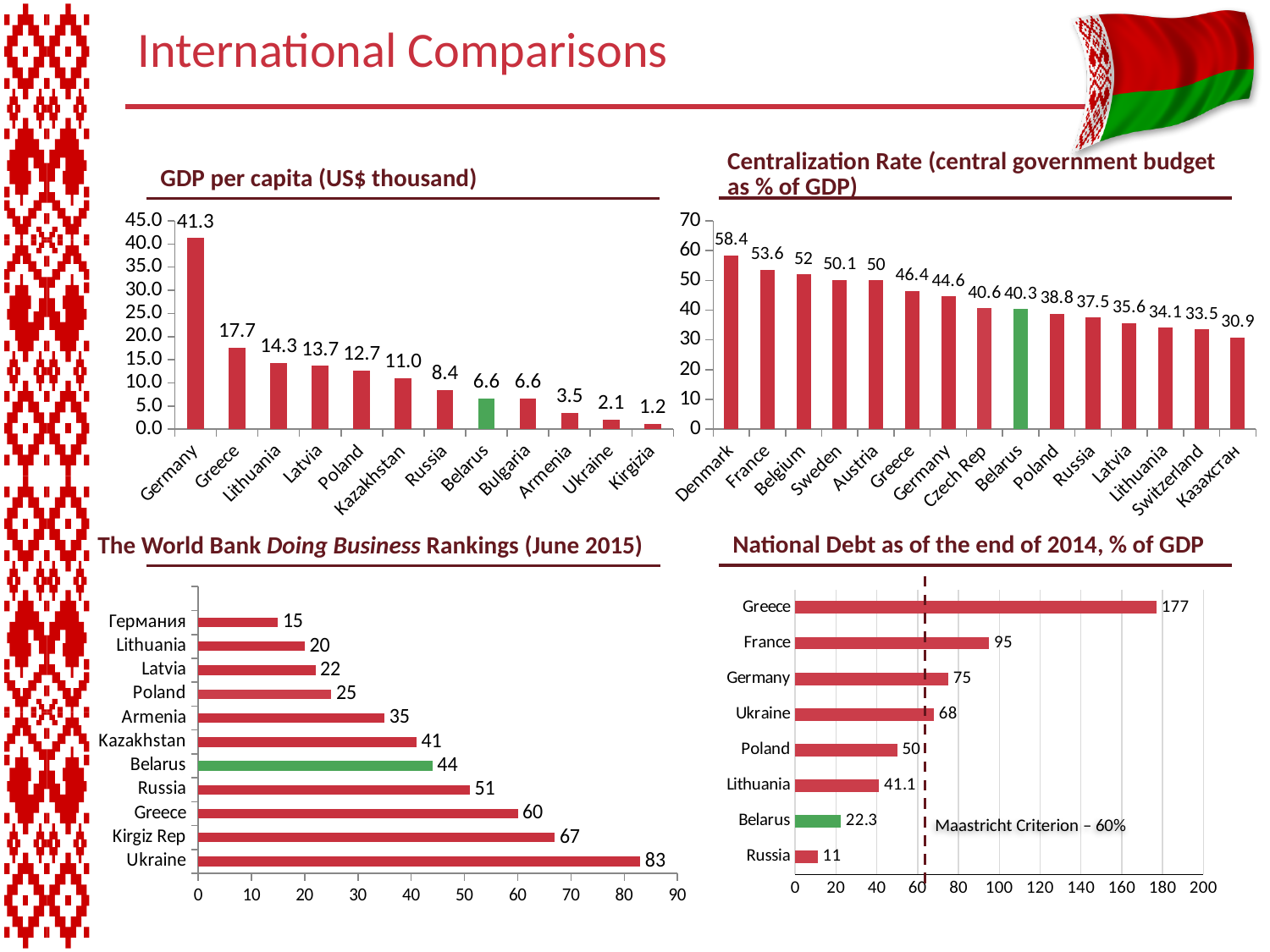
In the GDP per capita (US$ thousand) chart, which country has the highest value? Germany In the Centralization Rate chart, what is the value for Belarus? 40.3 In the National Debt as of the end of 2014 chart, what is the difference between Greece and France? 82 How many countries are shown in the Centralization Rate chart? 15 In The World Bank Doing Business Rankings chart, what is the value for Belarus? 44 In the Centralization Rate chart, which country has the lowest value? Казахстан How many countries are shown in the GDP per capita (US$ thousand) chart? 12 In the GDP per capita (US$ thousand) chart, what is the value for Belarus? 6.6 In The World Bank Doing Business Rankings chart, which country has the highest value? Ukraine In the GDP per capita (US$ thousand) chart, what is the difference between Germany and Greece? 23.6 In the Centralization Rate chart, which is larger, the value for France or the value for Belgium? France What type of chart is the National Debt as of the end of 2014, % of GDP chart? Bar chart